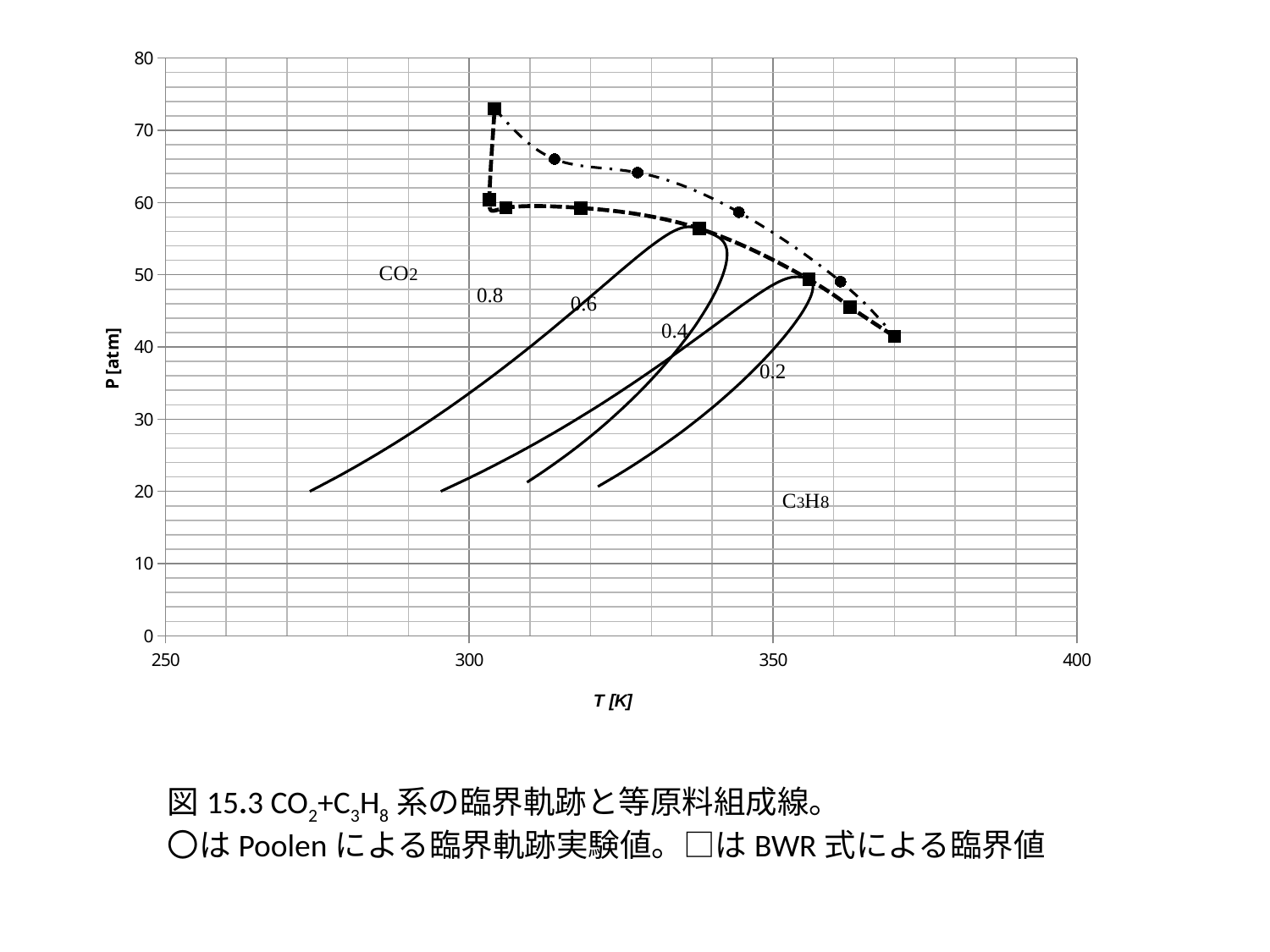
Is the pressure at the lower-left starting ends of the solid composition curves greater or less than 30 atm? less Which marker type reaches the highest pressure on the chart, the squares or the circles? squares How many numbered composition curves (0.8, 0.6, 0.4, 0.2) are labelled on the chart? 4 What is the maximum value shown on the x axis? 400 Is the pressure of the rightmost square marker (near T = 370 K) greater or less than 50 atm? less Is the pressure of the highest square marker (near T = 304 K) greater or less than 70 atm? greater What is the label of the y axis? P [atm] Along the dash-dot line of circle markers, does the pressure rise or fall as temperature increases? fall What is the maximum value shown on the y axis? 80 What is the label of the x axis? T [K] What kind of chart is shown on the slide? line chart